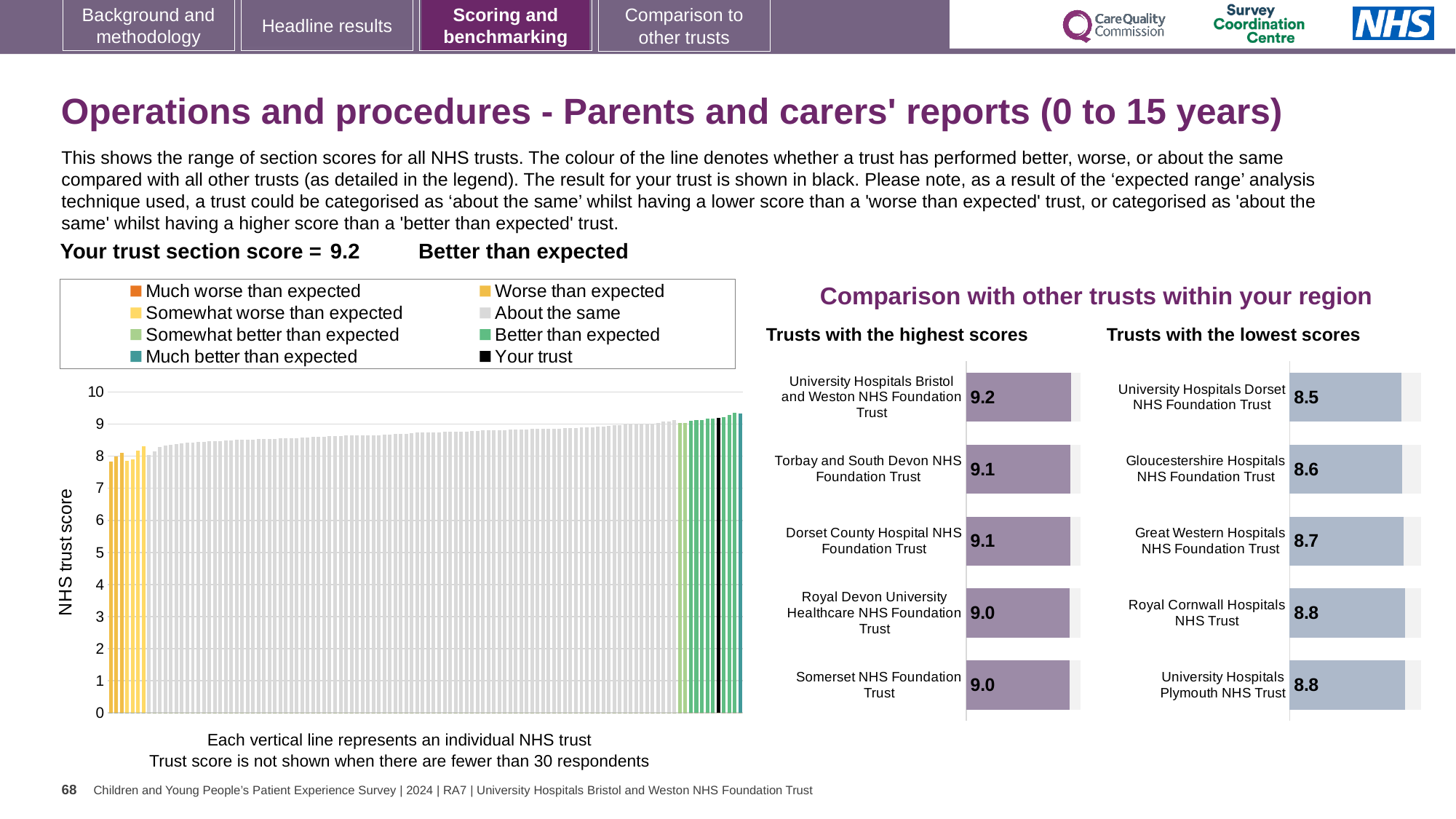
In the 'Trusts with the highest scores' chart, which trust has the highest score? University Hospitals Bristol and Weston NHS Foundation Trust How many entries does the legend of the main chart on the left list? 8 What kind of chart is the main chart on the left showing NHS trust scores? bar chart In the 'Trusts with the highest scores' chart, what is the score for University Hospitals Bristol and Weston NHS Foundation Trust? 9.2 In the 'Trusts with the highest scores' chart, what is the score for Royal Devon University Healthcare NHS Foundation Trust? 9.0 In the main chart on the left, is the value for the black bar (Your trust) greater or less than 9? greater In the 'Trusts with the lowest scores' chart, which trust has the lowest score? University Hospitals Dorset NHS Foundation Trust In the 'Trusts with the highest scores' chart, what is the difference between the scores of University Hospitals Bristol and Weston NHS Foundation Trust and Somerset NHS Foundation Trust? 0.2 In the 'Trusts with the lowest scores' chart, what is the score for Gloucestershire Hospitals NHS Foundation Trust? 8.6 In the main chart on the left, do the trust scores rise or fall from left to right? rise In the 'Trusts with the lowest scores' chart, which has the larger score: Great Western Hospitals NHS Foundation Trust or University Hospitals Dorset NHS Foundation Trust? Great Western Hospitals NHS Foundation Trust How many trusts are listed in the 'Trusts with the lowest scores' chart? 5